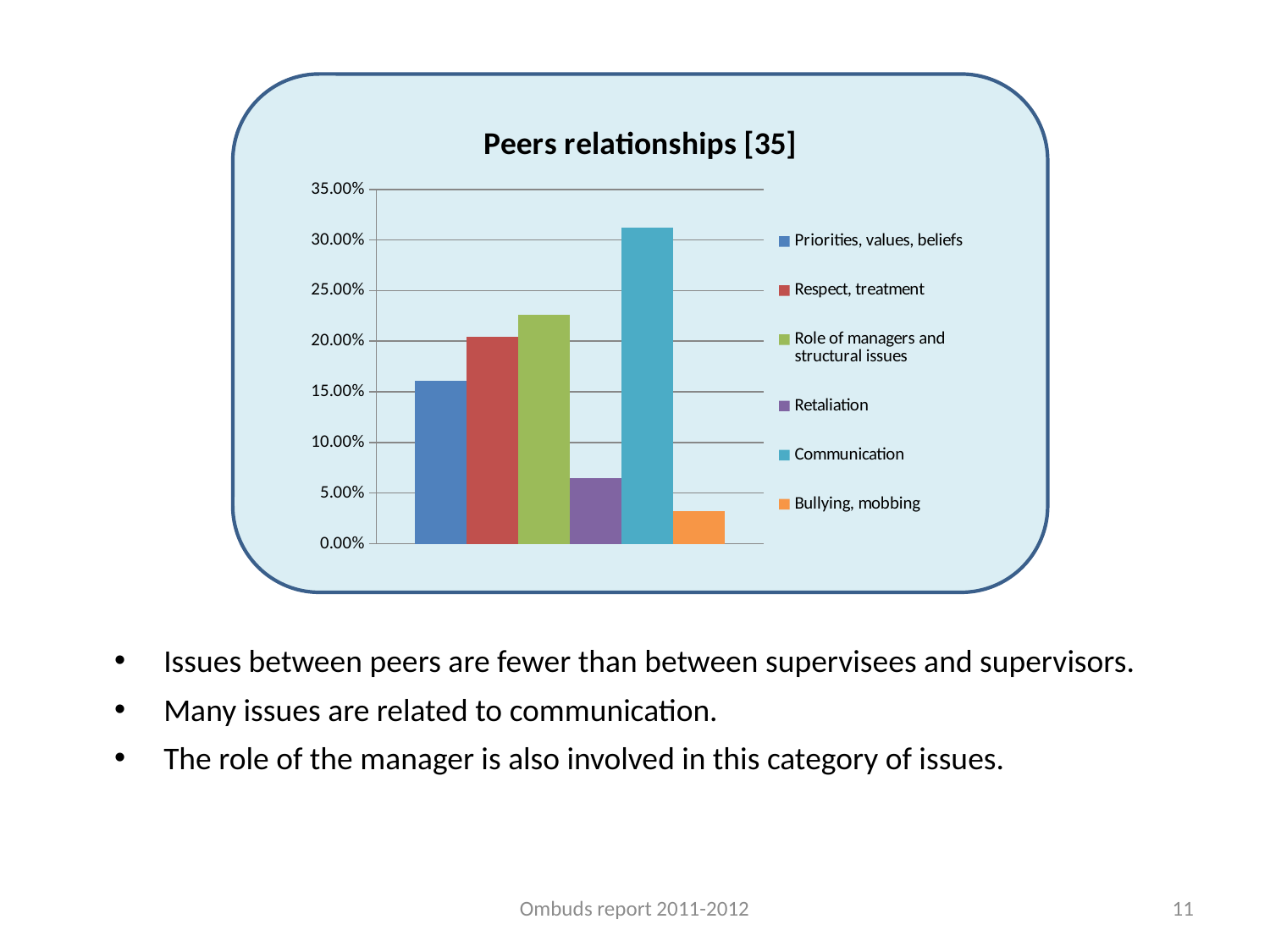
Is the value for Priorities, values, beliefs greater or less than 15.00%? greater Is the value for Bullying, mobbing greater or less than 5.00%? less Which category has the highest value in the chart? Communication Is the value for Communication greater or less than 30.00%? greater What kind of chart is shown on the slide? bar chart What is the title of the chart? Peers relationships [35] Which is larger, the value for Role of managers and structural issues or the value for Priorities, values, beliefs? Role of managers and structural issues Which is larger, the value for Respect, treatment or the value for Retaliation? Respect, treatment How many bars are plotted in the chart? 6 How many series does the chart legend list? 6 Which category has the lowest value in the chart? Bullying, mobbing